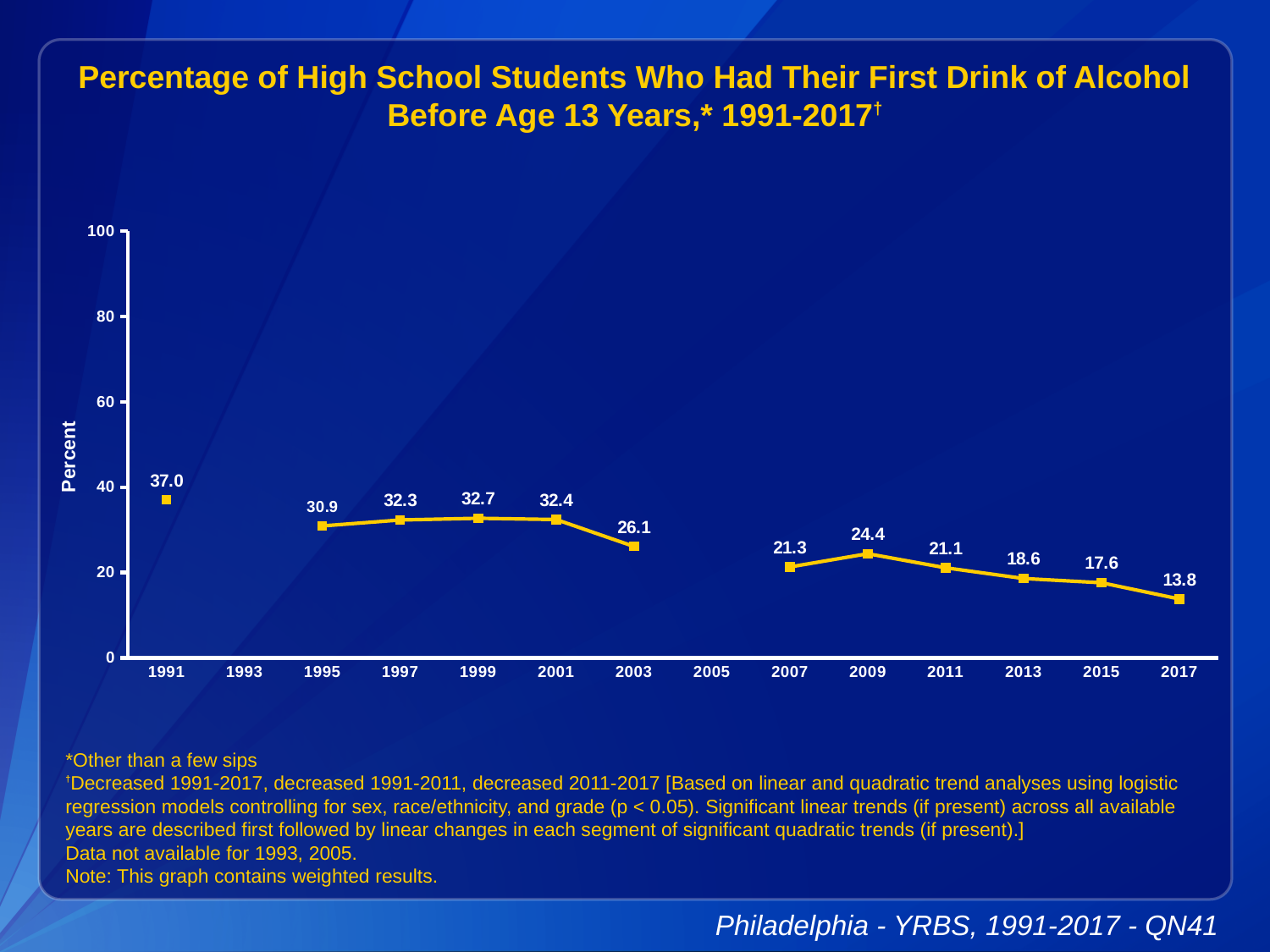
What is the value plotted for 2009? 24.4 Which year has the highest plotted value? 1991 Is the value for 1999 greater or less than 40? less What kind of chart is shown on the slide? line chart What percentage of high school students had their first drink of alcohol before age 13 in 1991? 37.0 How many years have data points plotted on the chart? 12 What is the difference between the values for 1991 and 2017? 23.2 Which year has the larger value, 2003 or 2007? 2003 What is the value plotted for 2017? 13.8 Which year has the lowest plotted value? 2017 Do the values generally rise or fall from 2009 to 2017? fall What is the label on the y axis? Percent